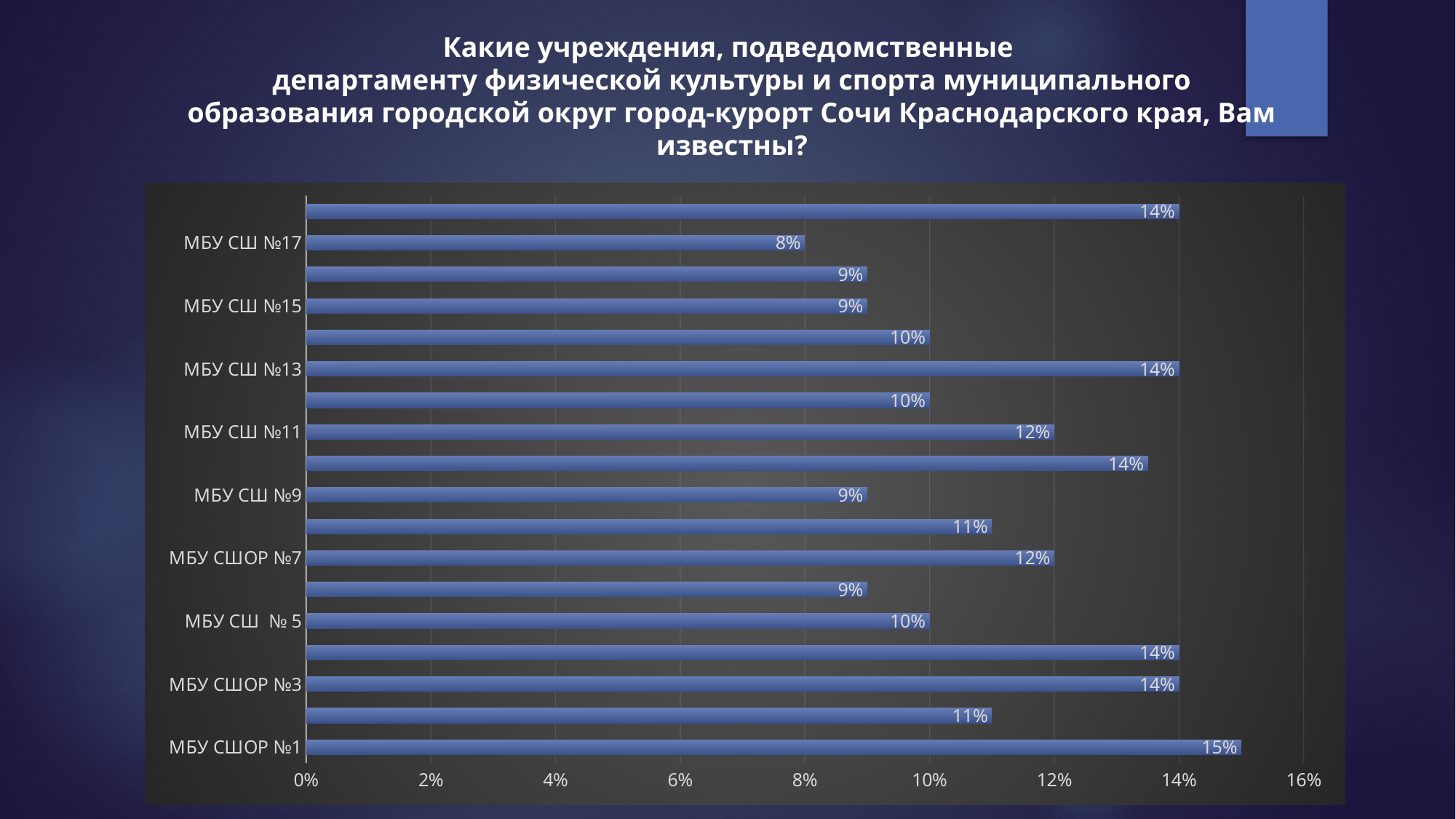
What type of chart is shown on the slide? Bar chart Which labelled institution has the lowest value? МБУ СШ №17 What is the value for МБУ СШ №9? 9% Which labelled institution has the highest value? МБУ СШОР №1 Which is larger, the value for МБУ СШОР №7 or the value for МБУ СШ №9? МБУ СШОР №7 What is the value for МБУ СШ №13? 14% What is the difference between the values for МБУ СШОР №1 and МБУ СШ №17? 7% Is the value for МБУ СШ №13 greater or less than 12%? greater How many bars are plotted in the chart? 18 What is the value for МБУ СШОР №1? 15% What is the value for МБУ СШ №17? 8% What is the value for МБУ СШОР №7? 12%